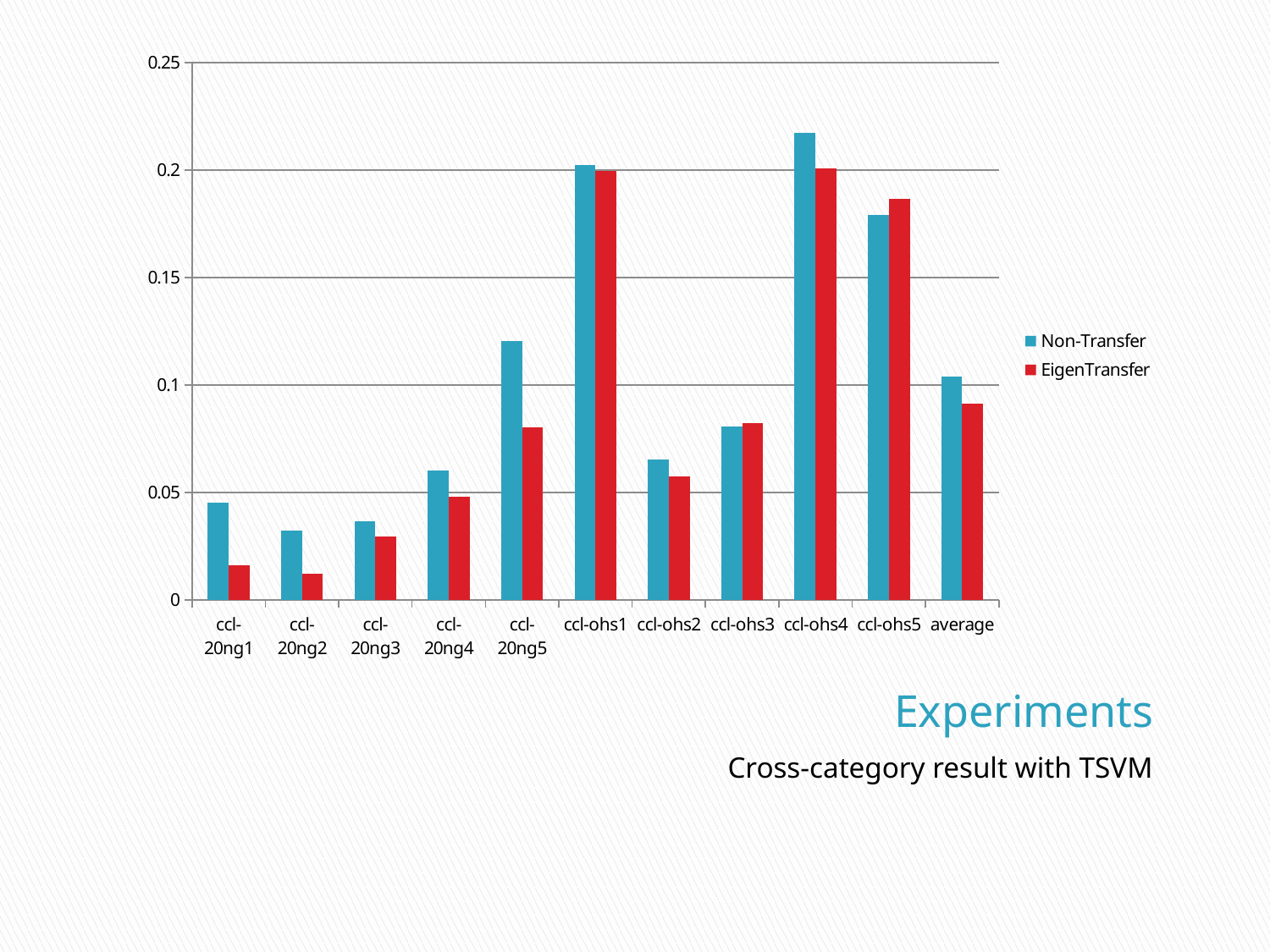
Is the EigenTransfer value for ccl-ohs5 greater or less than 0.15? greater Is the EigenTransfer value for ccl-20ng1 greater or less than 0.05? less For ccl-ohs5, which series has the larger value, Non-Transfer or EigenTransfer? EigenTransfer For ccl-20ng1, which series has the larger value, Non-Transfer or EigenTransfer? Non-Transfer What kind of chart is shown on the slide? bar chart How many categories are shown along the x axis? 11 Is the Non-Transfer value for ccl-20ng5 greater or less than 0.1? greater Which colour represents the EigenTransfer series in the legend? red Which category has the lowest EigenTransfer value? ccl-20ng2 How many series does the legend list? 2 Which category has the highest Non-Transfer value? ccl-ohs4